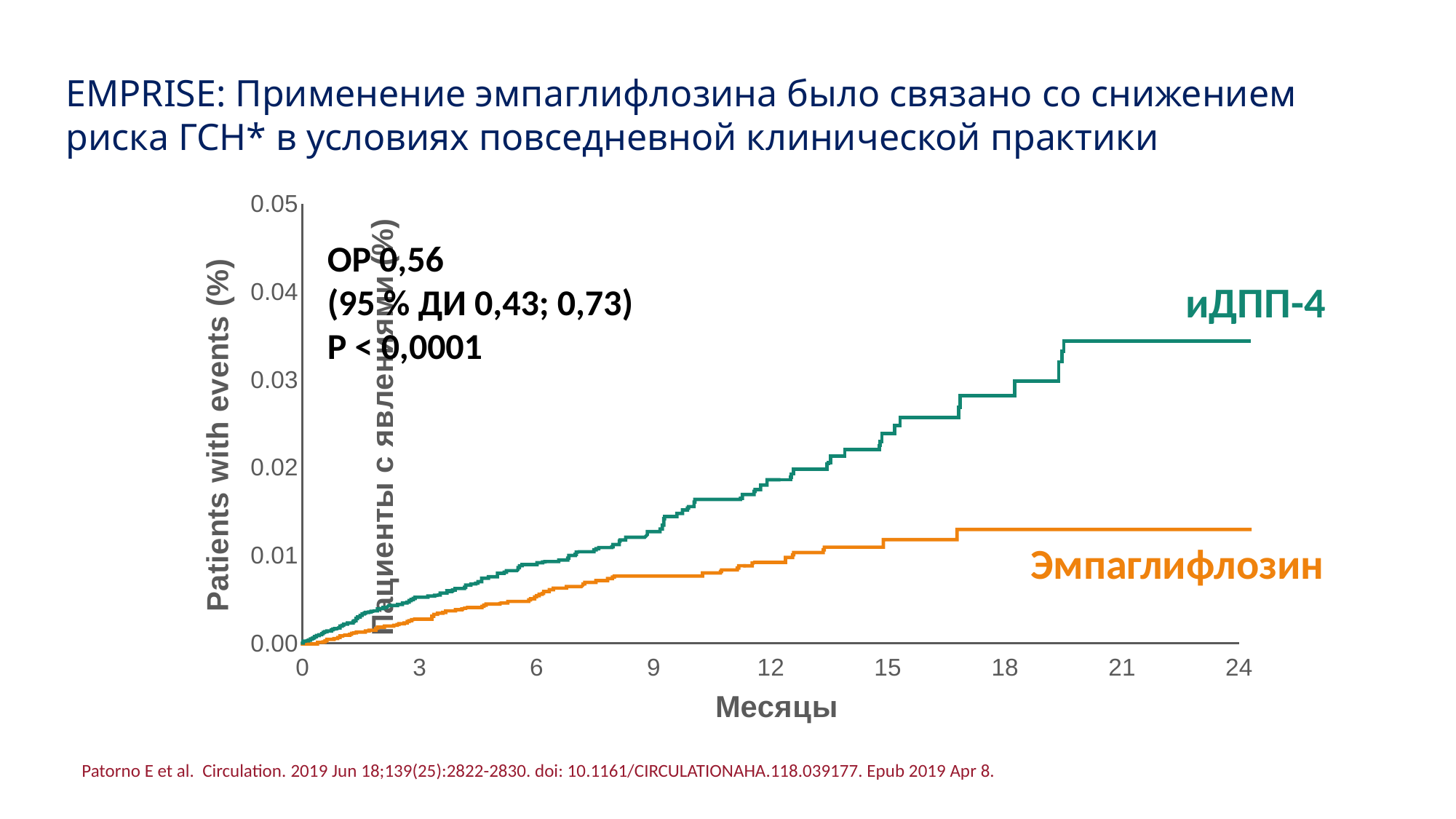
Is the value for иДПП-4 at 24 months greater or less than 0.03? greater What kind of chart is shown on the slide? line chart Do the values for иДПП-4 rise or fall along the x axis? rise What is the label of the x axis? Месяцы What hazard ratio (ОР) is annotated on the chart? 0,56 How many series are plotted on the chart? 2 Is the value for Эмпаглифлозин at 12 months greater or less than 0.02? less What is the highest tick value shown on the x axis? 24 Is the value for Эмпаглифлозин at 24 months greater or less than 0.02? less Which series reaches the lowest value at the end of follow-up? Эмпаглифлозин Which series has the higher value at 24 months, иДПП-4 or Эмпаглифлозин? иДПП-4